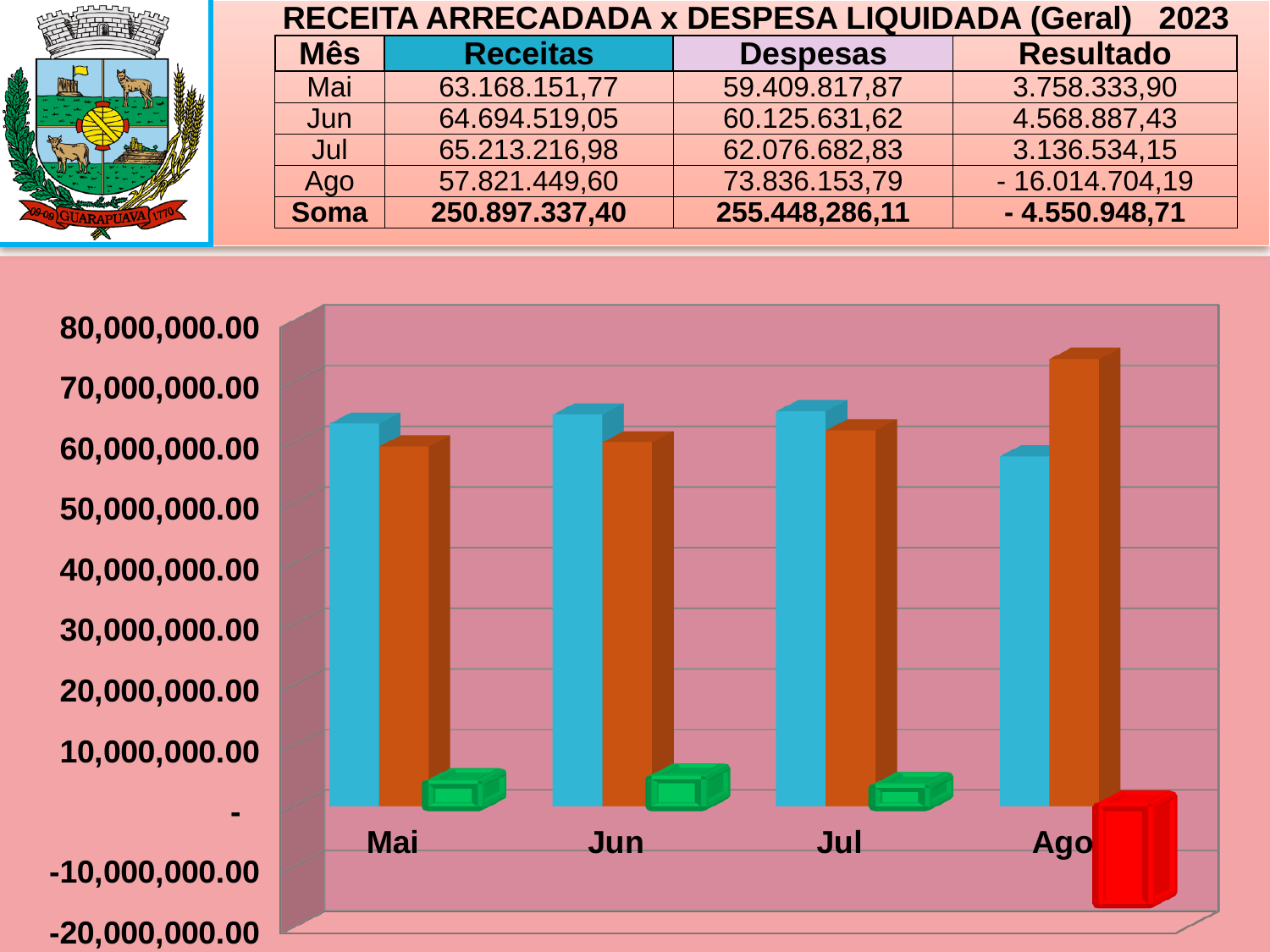
How many months are shown on the x axis of the chart? 4 Do the orange (Despesas) bars rise or fall from Mai to Ago? rise Is the value of the blue (Receitas) bar for Ago greater or less than 60,000,000.00? less Which month has a bar that goes below zero in the chart? Ago Is the value of the blue (Receitas) bar for Mai greater or less than 60,000,000.00? greater Which month has the tallest bar in the chart? Ago In Ago, which bar is taller: the blue (Receitas) bar or the orange (Despesas) bar? orange (Despesas) What kind of chart is shown on the slide? bar chart In Mai, which bar is taller: the blue (Receitas) bar or the orange (Despesas) bar? blue (Receitas) According to the table on the slide, what is the Receitas value for Mai? 63.168.151,77 According to the table on the slide, what is the Despesas value for Ago? 73.836.153,79 Is the value of the orange (Despesas) bar for Ago greater or less than 70,000,000.00? greater